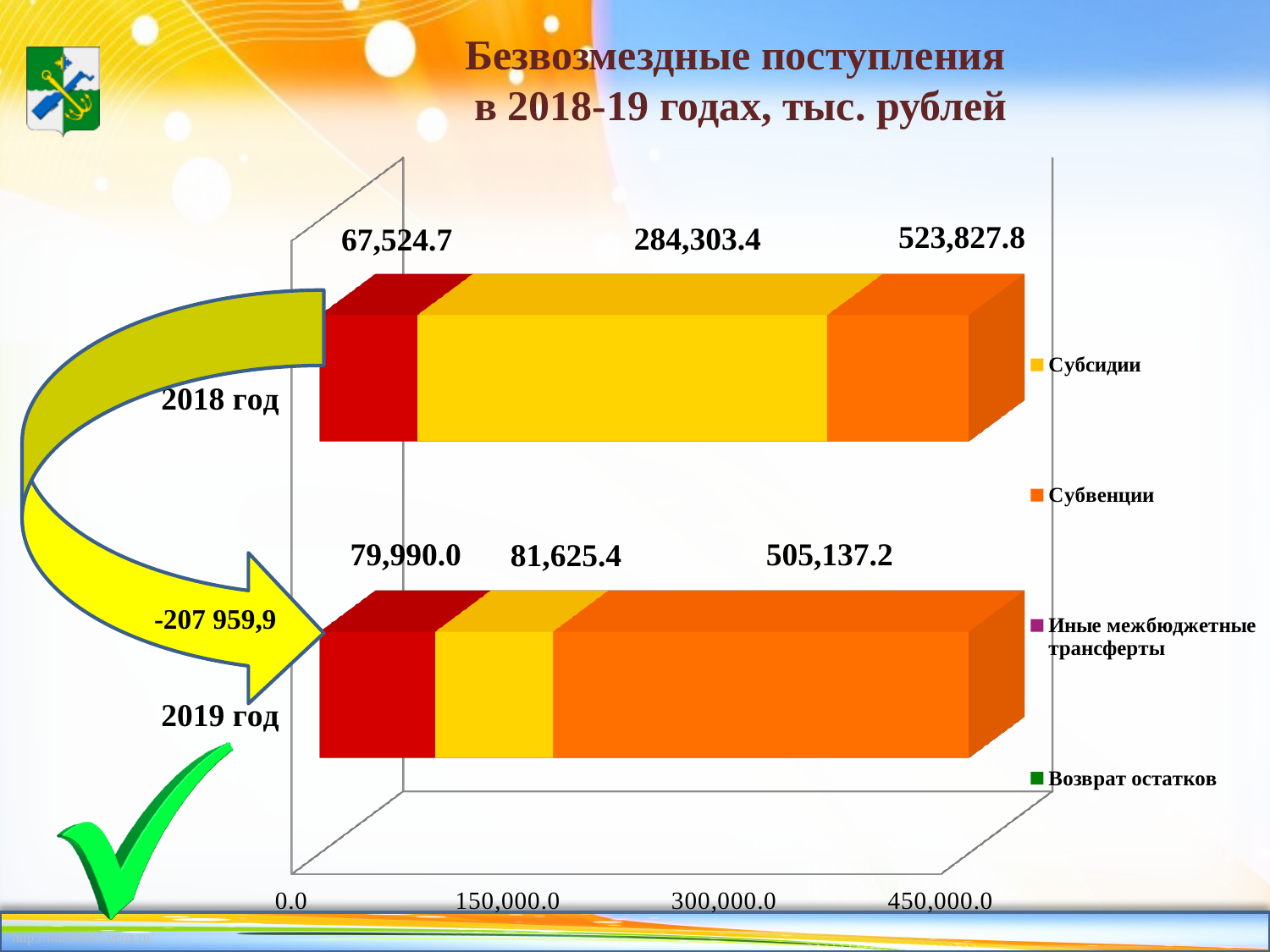
For 2019 год, which is larger: Субсидии or Субвенции? Субвенции What is the value of Субвенции for 2019 год? 505,137.2 What is the value labelled on the leftmost (red) segment of the 2018 год bar? 67,524.7 What value is written on the yellow arrow pointing to the 2019 год bar? -207 959,9 What is the value of Субсидии for 2019 год? 81,625.4 How many years (bars) does the chart show? 2 By how much does the leftmost (red) segment value of 2019 год exceed that of 2018 год? 12,465.3 How many series does the legend list? 4 What is the value labelled on the leftmost (red) segment of the 2019 год bar? 79,990.0 What is the title of the chart? Безвозмездные поступления в 2018-19 годах, тыс. рублей What kind of chart is shown on the slide? bar chart For 2019 год, what is the difference between Субвенции and Субсидии? 423,511.8